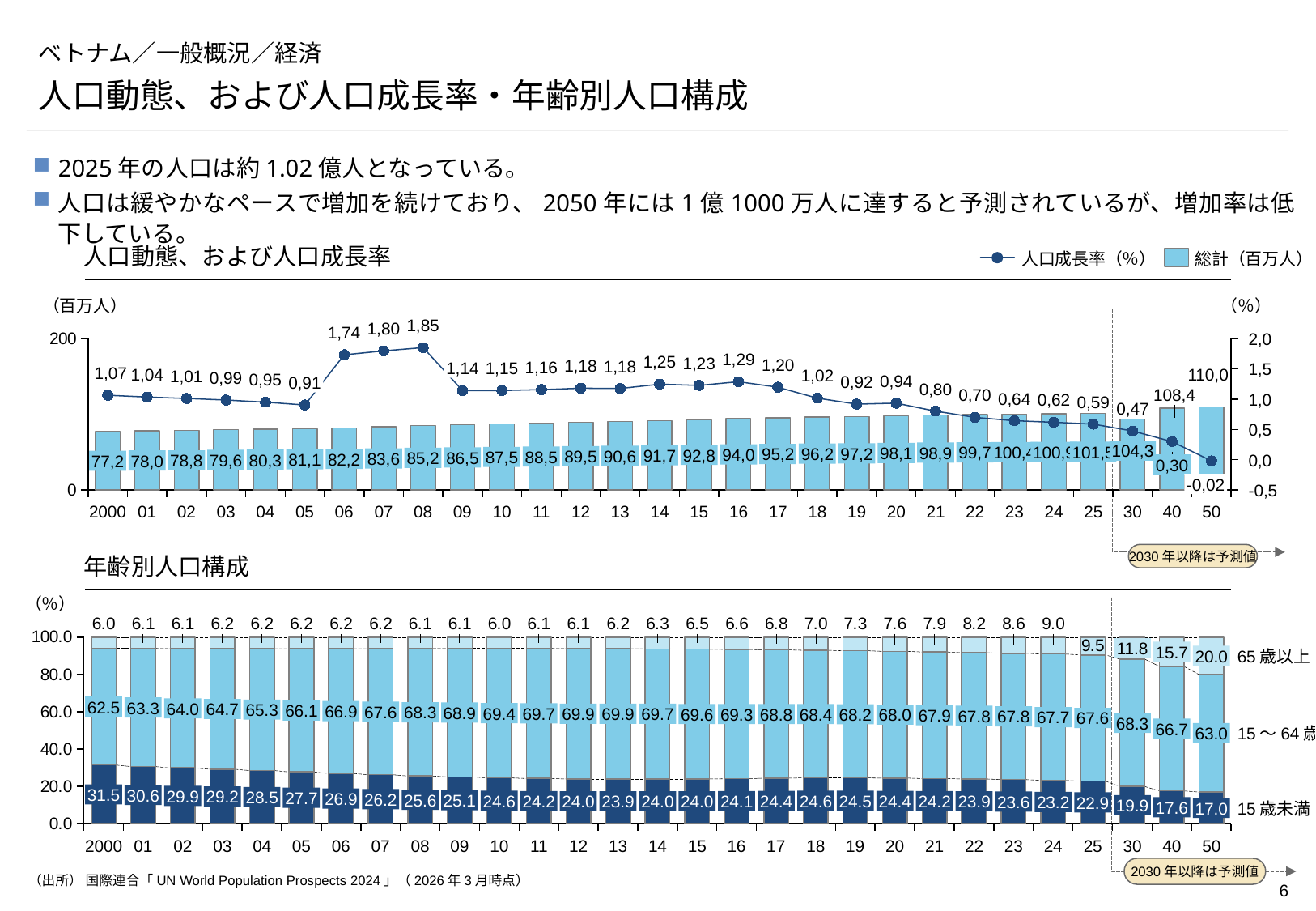
In the top chart (人口動態、および人口成長率), what is the population growth rate (%) shown for 2008? 1,85 In the top chart (人口動態、および人口成長率), what is the total population (百万人) shown for 2000? 77,2 In the bottom chart (年齢別人口構成), which year has the highest share of 15～64歳? 2012 and 2013 (both 69.9) In the top chart (人口動態、および人口成長率), what is the difference in total population (百万人) between 2050 and 2030? 5,7 In the bottom chart (年齢別人口構成), what is the share (%) of 15歳未満 in 2000? 31.5 In the bottom chart (年齢別人口構成), is the share of 15歳未満 larger in 2000 or in 2050? 2000 In the top chart (人口動態、および人口成長率), which year has the highest population growth rate? 2008 In the top chart (人口動態、および人口成長率), what is the population growth rate (%) shown for 2050? -0,02 In the top chart (人口動態、および人口成長率), does the population growth rate rise or fall from 2016 to 2050? fall In the bottom chart (年齢別人口構成), what is the share (%) of 65歳以上 in 2050? 20.0 What kind of chart is the bottom chart (年齢別人口構成)? stacked bar chart In the top chart (人口動態、および人口成長率), how many series does the legend list? 2